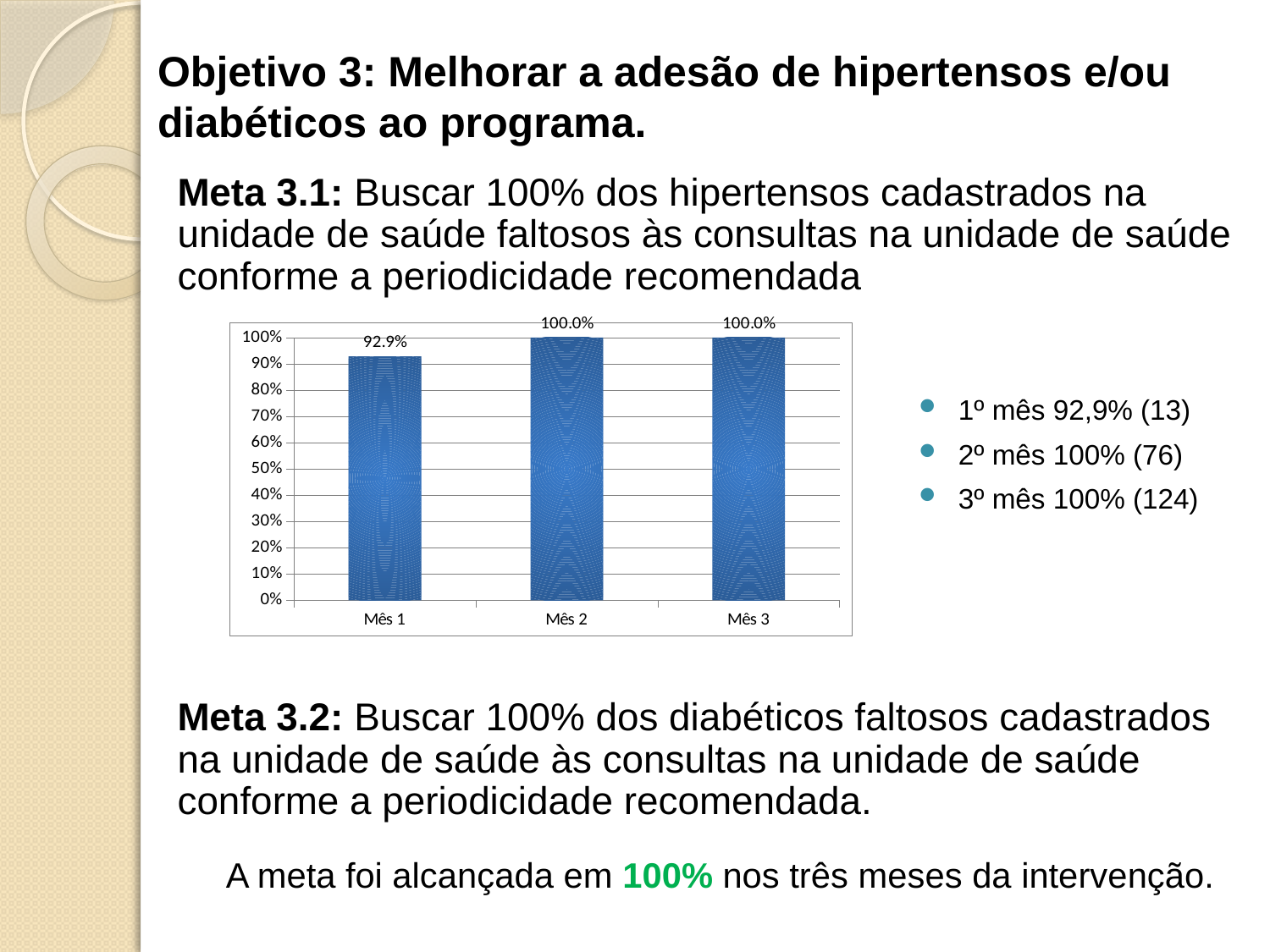
Do the values rise or fall from Mês 1 to Mês 2? rise What is the value for Mês 2 in the bar chart? 100.0% How many months (categories) are shown on the x axis of the chart? 3 Which is larger, the value for Mês 1 or the value for Mês 3? Mês 3 What kind of chart is shown on the slide? bar chart What is the difference between the values for Mês 2 and Mês 1? 7.1% Is the value for Mês 1 greater or less than 90%? greater What is the value for Mês 3 in the bar chart? 100.0% What is the value for Mês 1 in the bar chart? 92.9% Is the value for Mês 1 greater or less than 100%? less What colour are the bars in the chart? blue Which month has the lowest value in the bar chart? Mês 1